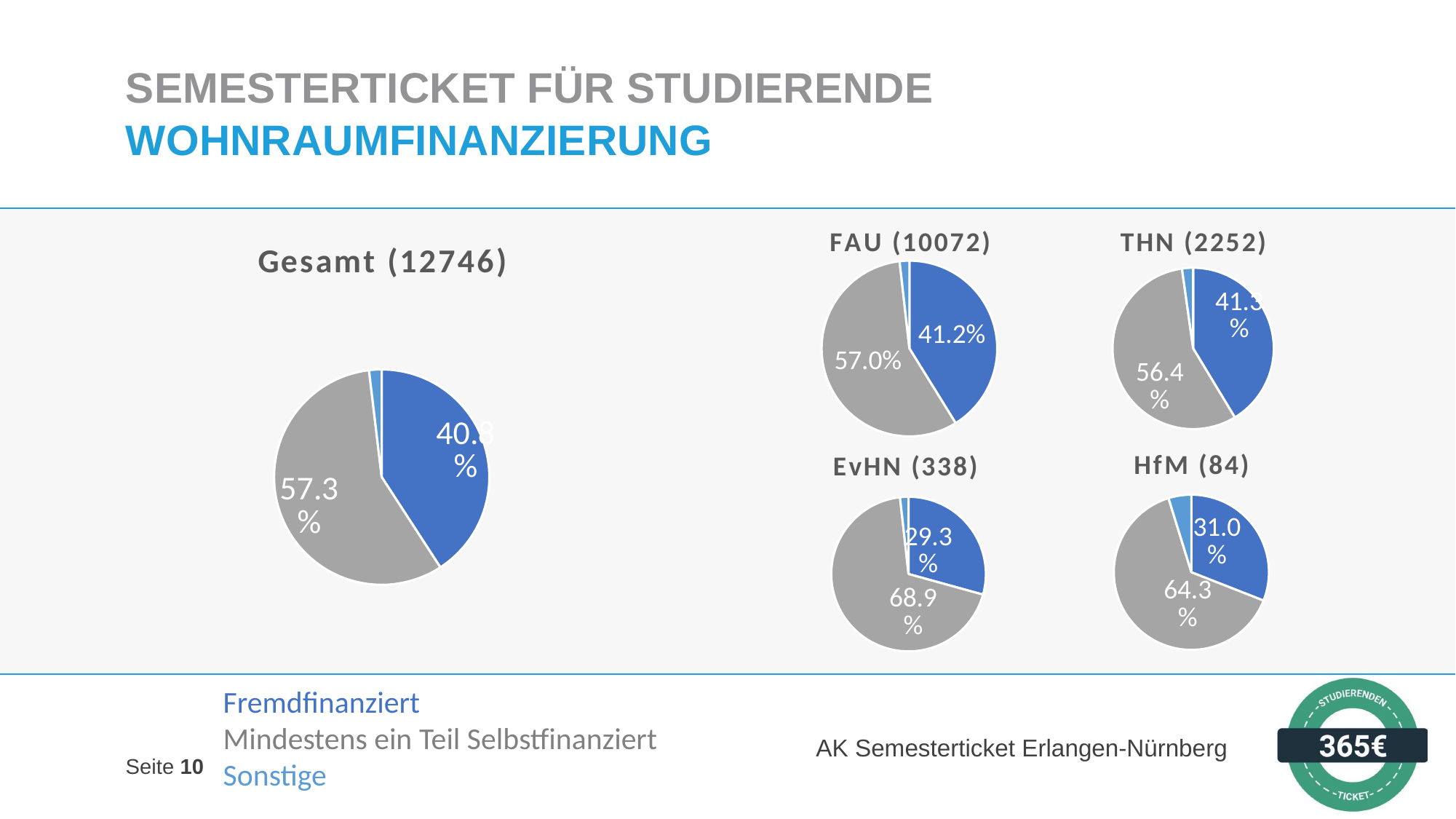
In the Gesamt (12746) pie chart, what share is labelled for the Fremdfinanziert slice? 40.8% In the FAU (10072) pie chart, what percentage is shown for the Fremdfinanziert slice? 41.2% In the Gesamt (12746) pie chart, what share is labelled for the Mindestens ein Teil Selbstfinanziert slice? 57.3% Is the Fremdfinanziert share larger in the HfM (84) pie chart or in the EvHN (338) pie chart? HfM (84) Across the four university pie charts (FAU, THN, EvHN, HfM), which has the lowest Fremdfinanziert share? EvHN (338) How many categories does the legend at the bottom of the slide list? 3 In the THN (2252) pie chart, what percentage is shown for the Mindestens ein Teil Selbstfinanziert slice? 56.4% In the EvHN (338) pie chart, what percentage is shown for the Fremdfinanziert slice? 29.3% What type of chart is used to show the Wohnraumfinanzierung data on this slide? Pie chart In the HfM (84) pie chart, what percentage is shown for the Mindestens ein Teil Selbstfinanziert slice? 64.3% In the Gesamt (12746) pie chart, what is the difference in percentage points between the Mindestens ein Teil Selbstfinanziert slice and the Fremdfinanziert slice? 16.5% Across the four university pie charts (FAU, THN, EvHN, HfM), which has the highest Mindestens ein Teil Selbstfinanziert share? EvHN (338)